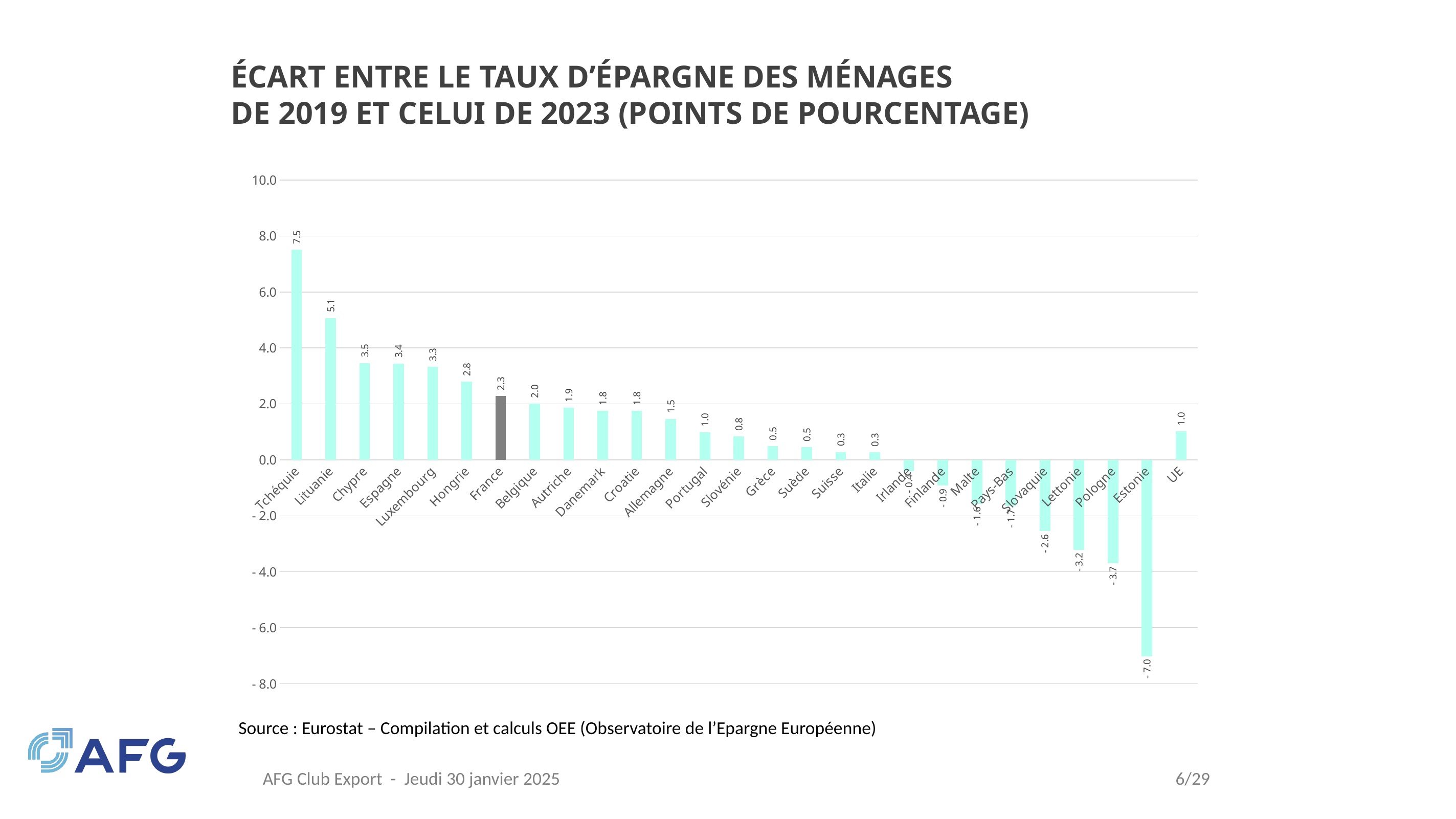
Which category's bar is coloured differently (grey) from the others? France Which category has the lowest value? Estonie What is the value for Pologne? -3.7 Is the value for Estonie greater or less than -6.0? less What is the value for Tchéquie? 7.5 What is the value for UE? 1.0 What kind of chart is shown on the slide? bar chart What is the difference between the values for Tchéquie and Lituanie? 2.4 How many categories are shown on the x axis? 27 Which category has the highest value? Tchéquie What is the value for France? 2.3 Which is larger, the value for Hongrie or the value for Belgique? Hongrie